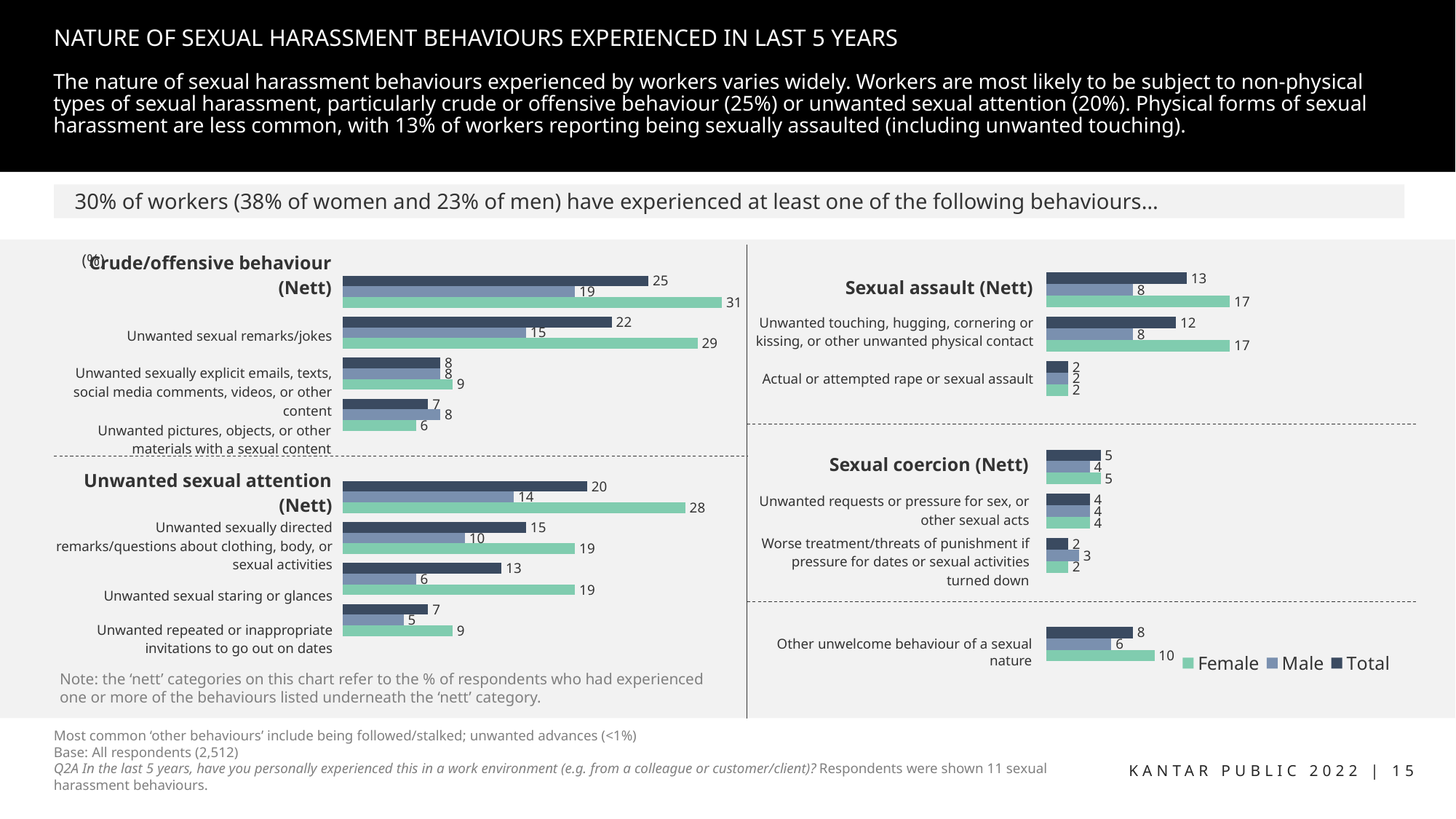
On the right chart, what is the difference between the Female and Male values for Unwanted touching, hugging, cornering or kissing, or other unwanted physical contact? 9 What kind of chart is shown on the slide? bar chart How many series does the legend list? 3 On the left chart, what is the difference between the Female and Male values for Unwanted sexual attention (Nett)? 14 On the left chart, is the Female value for Unwanted sexual staring or glances larger or smaller than the Male value? larger On the left chart, what is the Male value for Unwanted sexual remarks/jokes? 15 Which series is shown in green in the legend? Female On the left chart, which category has the highest Female value? Crude/offensive behaviour (Nett) On the left chart, what is the Female value for Crude/offensive behaviour (Nett)? 31 On the right chart, what is the Female value for Other unwelcome behaviour of a sexual nature? 10 On the right chart, what is the Total value for Sexual assault (Nett)? 13